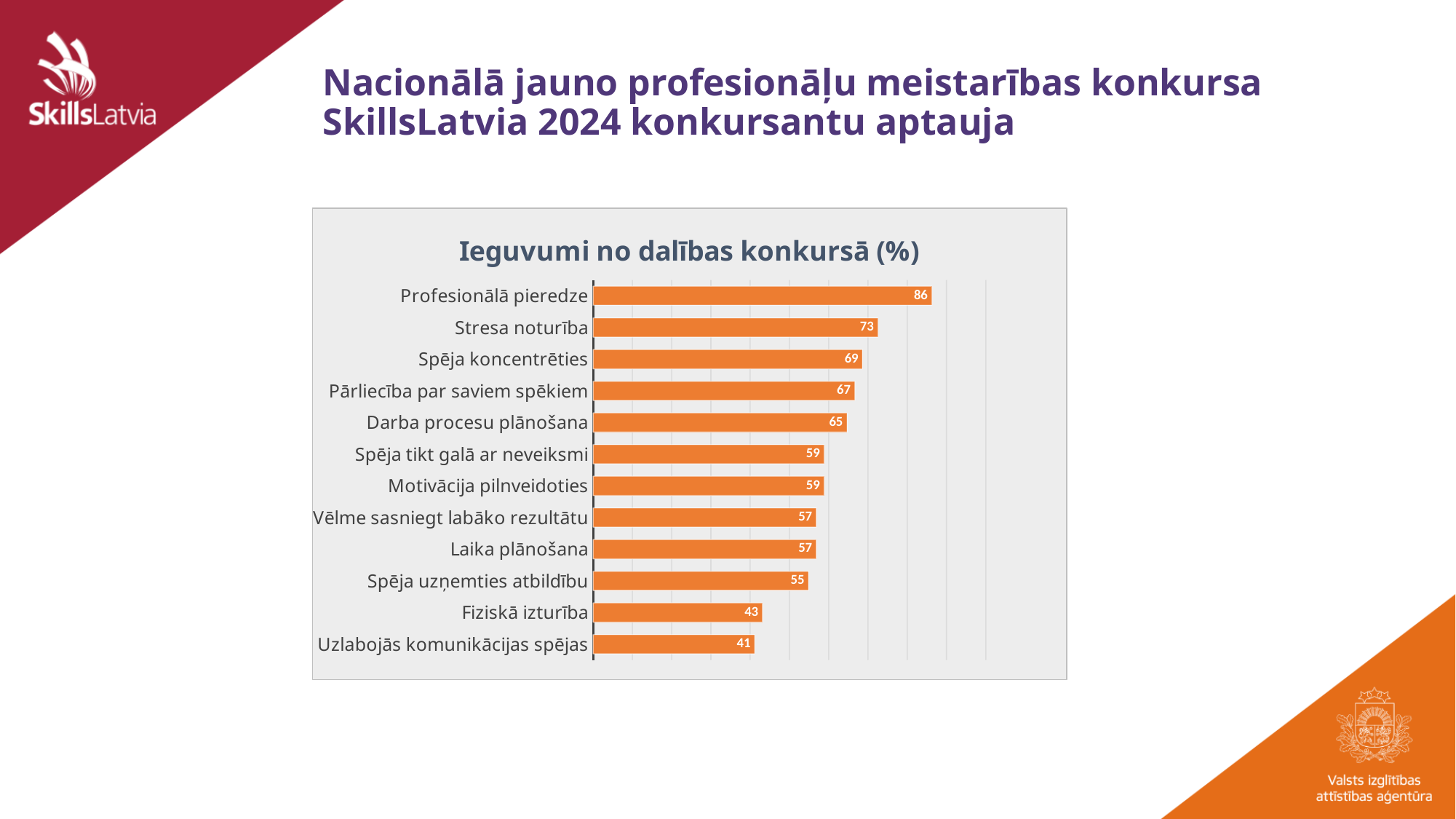
Which is larger, the value for Stresa noturība or the value for Pārliecība par saviem spēkiem? Stresa noturība What is the difference between the values for Profesionālā pieredze and Stresa noturība? 13 What is the title of the chart? Ieguvumi no dalības konkursā (%) What colour are the bars in the chart? Orange What is the value for Fiziskā izturība? 43 Which category has the lowest value? Uzlabojās komunikācijas spējas What kind of chart is shown on the slide? Bar chart Which category has the highest value? Profesionālā pieredze What is the difference between the values for Spēja koncentrēties and Spēja uzņemties atbildību? 14 How many categories are shown in the chart? 12 What is the value for Darba procesu plānošana? 65 What is the value for Profesionālā pieredze? 86